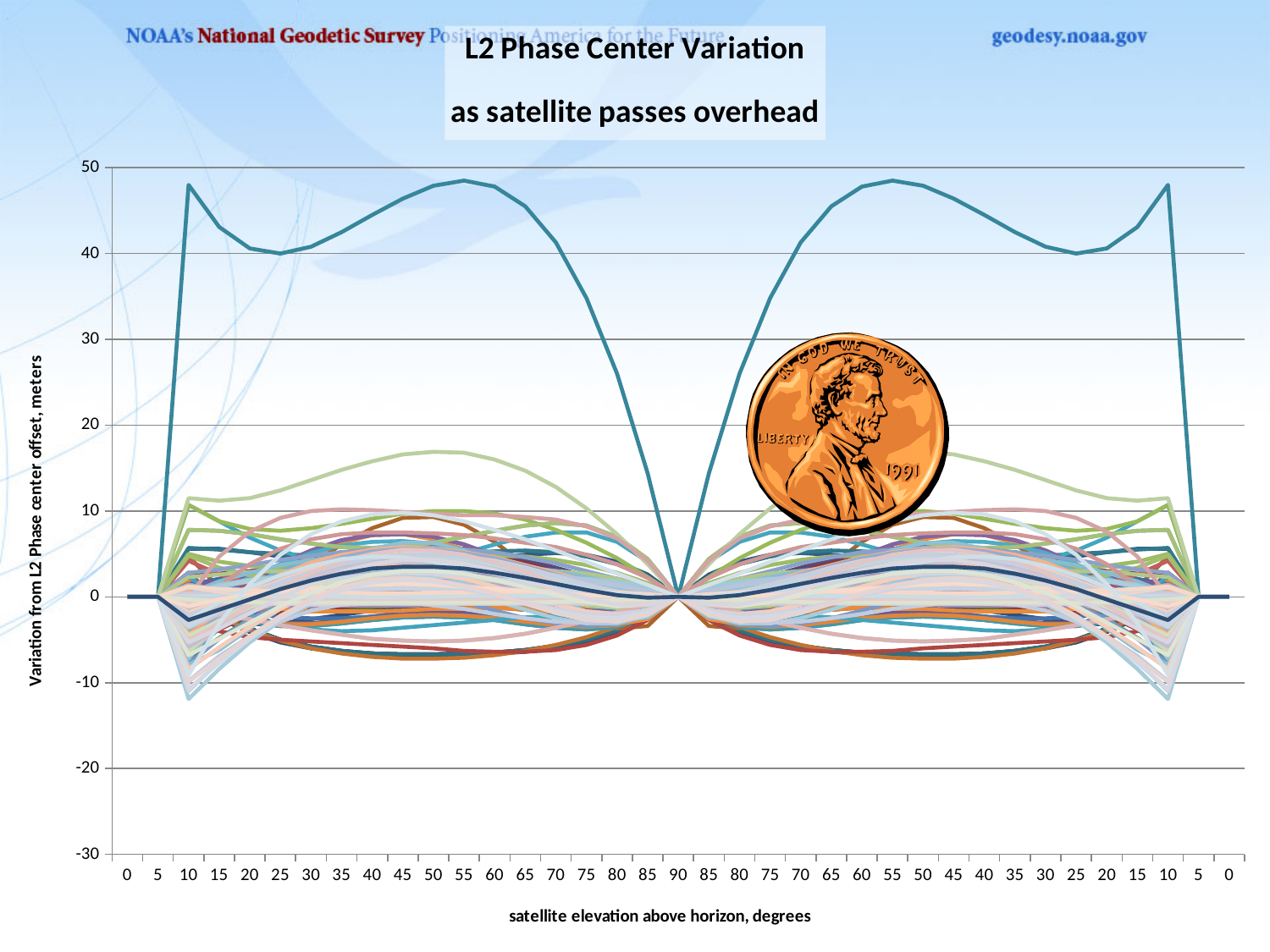
What kind of chart is shown on the slide? line chart Does the highest line rise or fall as elevation goes from 55 to 90 degrees? fall Is the value of the highest line at 75 degrees elevation greater or less than 40? less What is the label of the vertical axis? Variation from L2 Phase center offset, meters What is the highest value shown on the vertical axis? 50 Is the value of the highest line at 10 degrees elevation greater or less than 40? greater What is the title of the chart? L2 Phase Center Variation as satellite passes overhead Is the value of the lowest line at 10 degrees elevation greater or less than -10? less At which elevation on the x axis do all the lines meet at a single point? 90 What value do all the lines converge to at 90 degrees elevation? 0